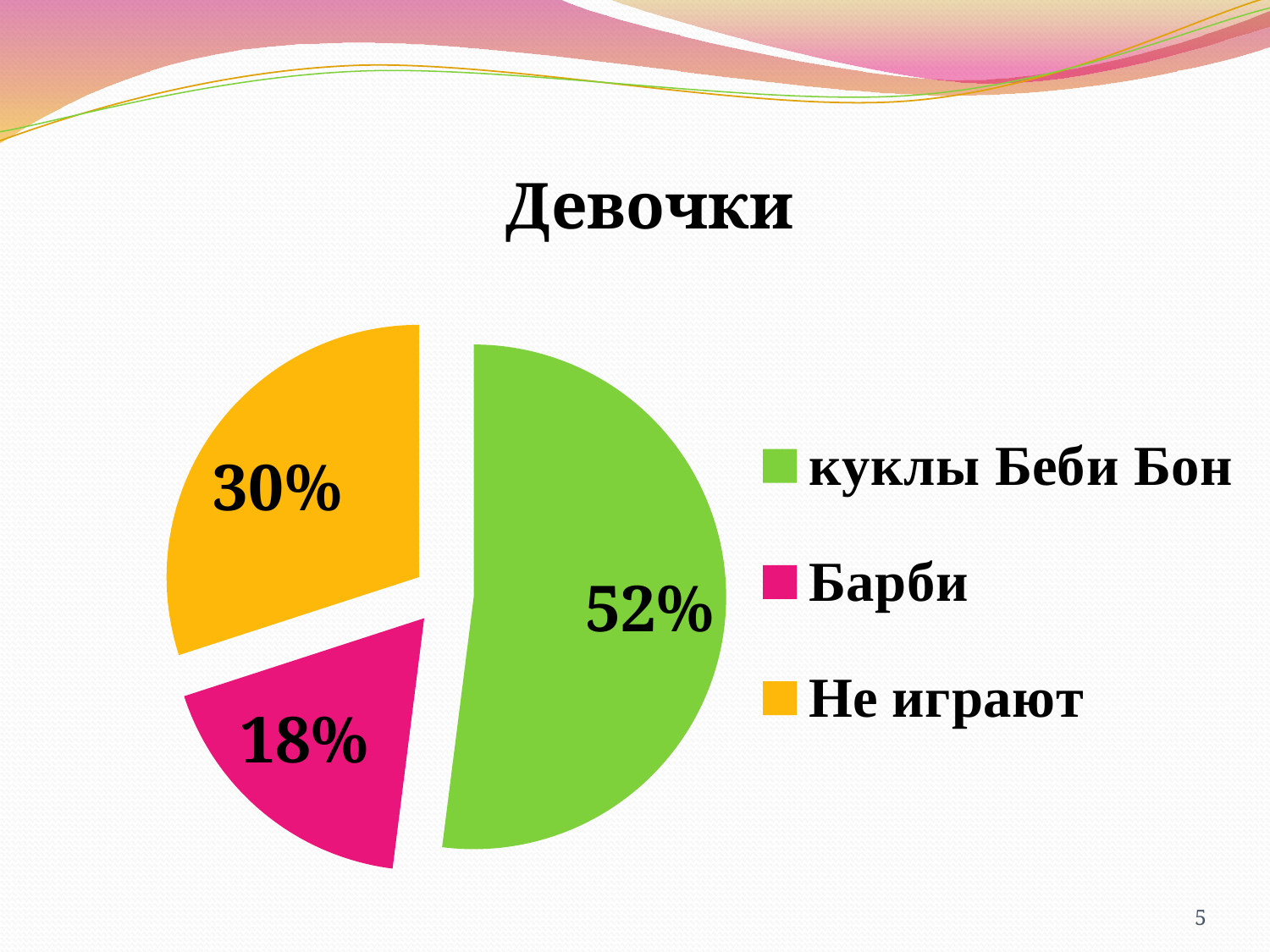
What type of chart is shown on the slide? pie chart Which is larger, the share for "Барби" or the share for "Не играют"? Не играют What is the difference in percentage points between "куклы Беби Бон" and "Не играют"? 22 What is the difference in percentage points between "Не играют" and "Барби"? 12 What share of the pie is labelled "куклы Беби Бон"? 52% Which category has the largest slice of the pie? куклы Беби Бон What is the title of the chart? Девочки What share of the pie is labelled "Не играют"? 30% Which category has the smallest slice of the pie? Барби What share of the pie is labelled "Барби"? 18% How many categories does the pie chart show? 3 What colour is the slice for "Барби"? pink